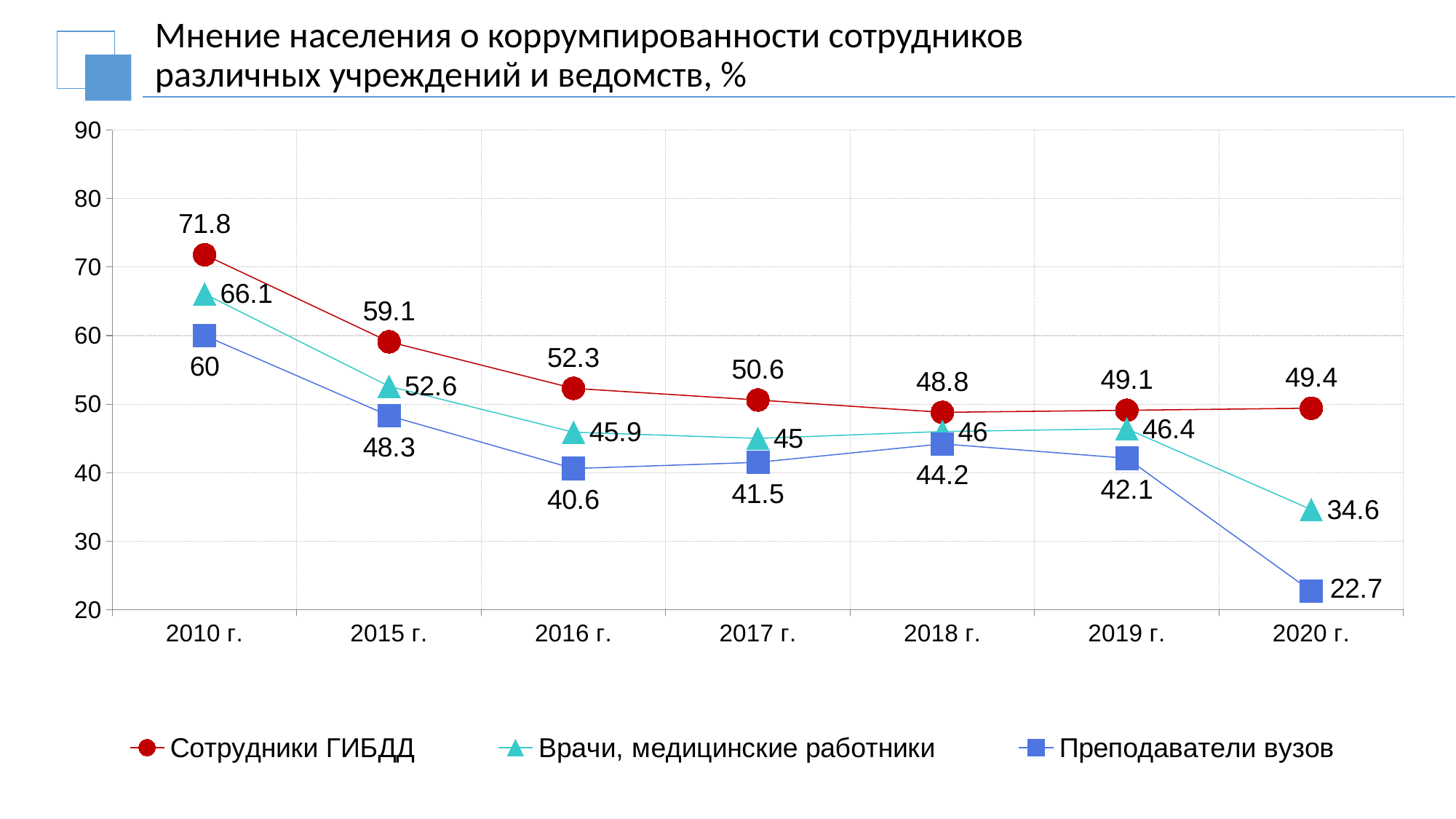
How many years are shown on the x axis? 7 Does the value for Преподаватели вузов rise or fall from 2010 г. to 2020 г.? fall In which year is the value for Врачи, медицинские работники the lowest? 2020 г. In which year is the value for Сотрудники ГИБДД the highest? 2010 г. What is the difference between the Сотрудники ГИБДД value and the Преподаватели вузов value in 2020 г.? 26.7 What type of chart is shown on the slide? line chart How many series does the legend list? 3 Which series has the larger value in 2019 г.: Врачи, медицинские работники or Преподаватели вузов? Врачи, медицинские работники Which series is shown with red circle markers? Сотрудники ГИБДД What is the value for Сотрудники ГИБДД in 2010 г.? 71.8 What is the value for Врачи, медицинские работники in 2018 г.? 46 What is the value for Преподаватели вузов in 2020 г.? 22.7